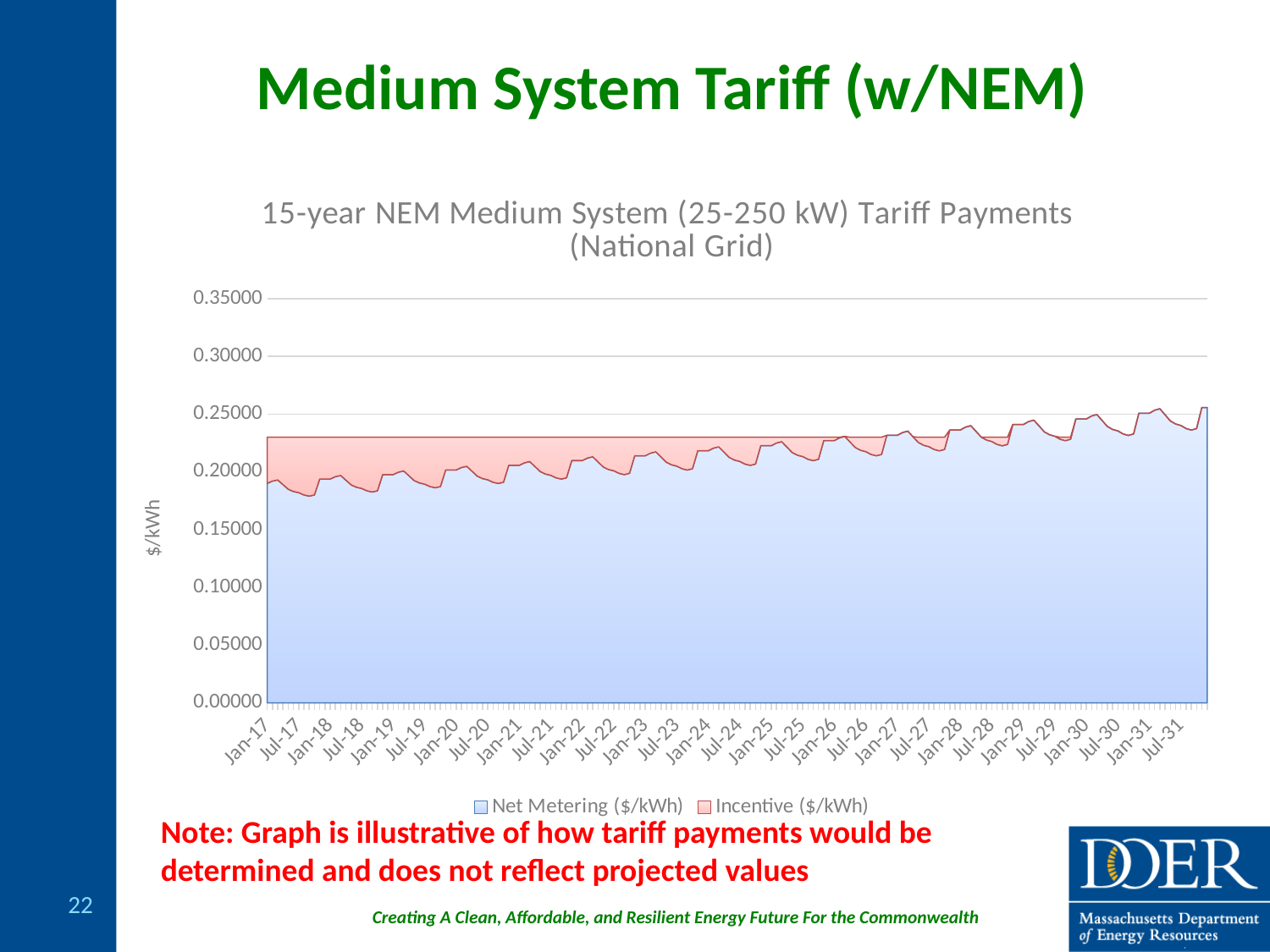
Is the Net Metering value at Jan-17 greater or less than 0.20000? less At Jan-17, which series contributes more to the total: Net Metering or Incentive? Net Metering Is the total stacked value (Net Metering plus Incentive) at Jan-17 greater or less than 0.25000? less How many series does the chart legend list? 2 What kind of chart is shown on the slide? Stacked area chart What is the label on the chart's vertical axis? $/kWh What are the two series named in the chart legend? Net Metering ($/kWh) and Incentive ($/kWh) What is the first month label shown on the x axis? Jan-17 Do the total tariff payments generally rise or fall from Jan-17 to Jul-31? Rise Does the total stacked value ever exceed 0.30000 on the chart? No